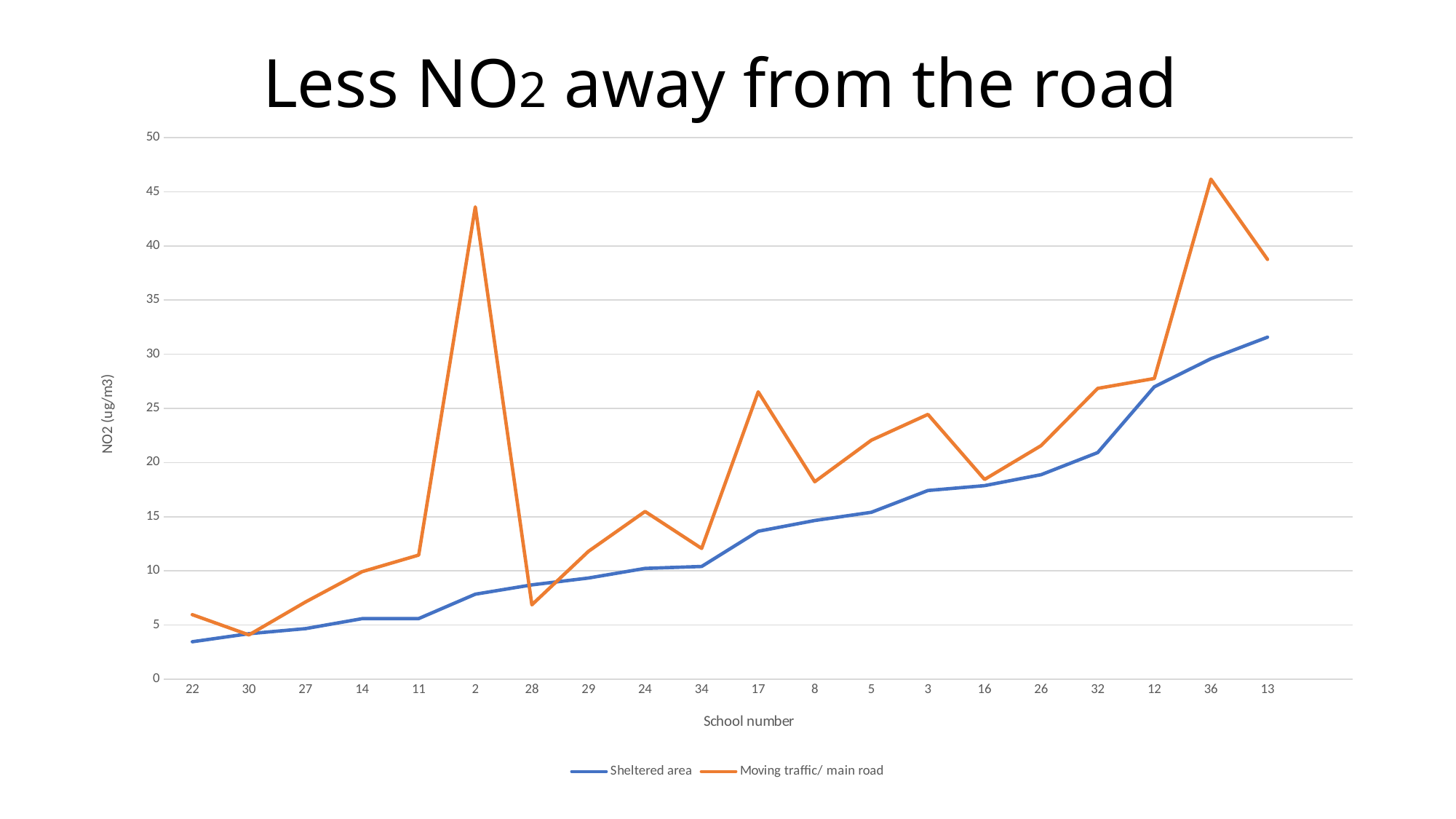
What kind of chart is shown on the slide? line chart Is the Moving traffic/ main road value for school 2 greater or less than 40? greater Does the Sheltered area series generally rise or fall from left to right along the x axis? rise Which school number has the highest value for the Moving traffic/ main road series? 36 Which school number has the lowest value for the Sheltered area series? 22 Is the Sheltered area value for school 13 greater or less than 30? greater Which school number has the highest value for the Sheltered area series? 13 At school 28, which series has the larger value: Sheltered area or Moving traffic/ main road? Sheltered area Is the Moving traffic/ main road value for school 28 greater or less than 10? less How many series does the legend list? 2 At school 2, which series has the larger value: Sheltered area or Moving traffic/ main road? Moving traffic/ main road How many school numbers are shown along the x axis? 20